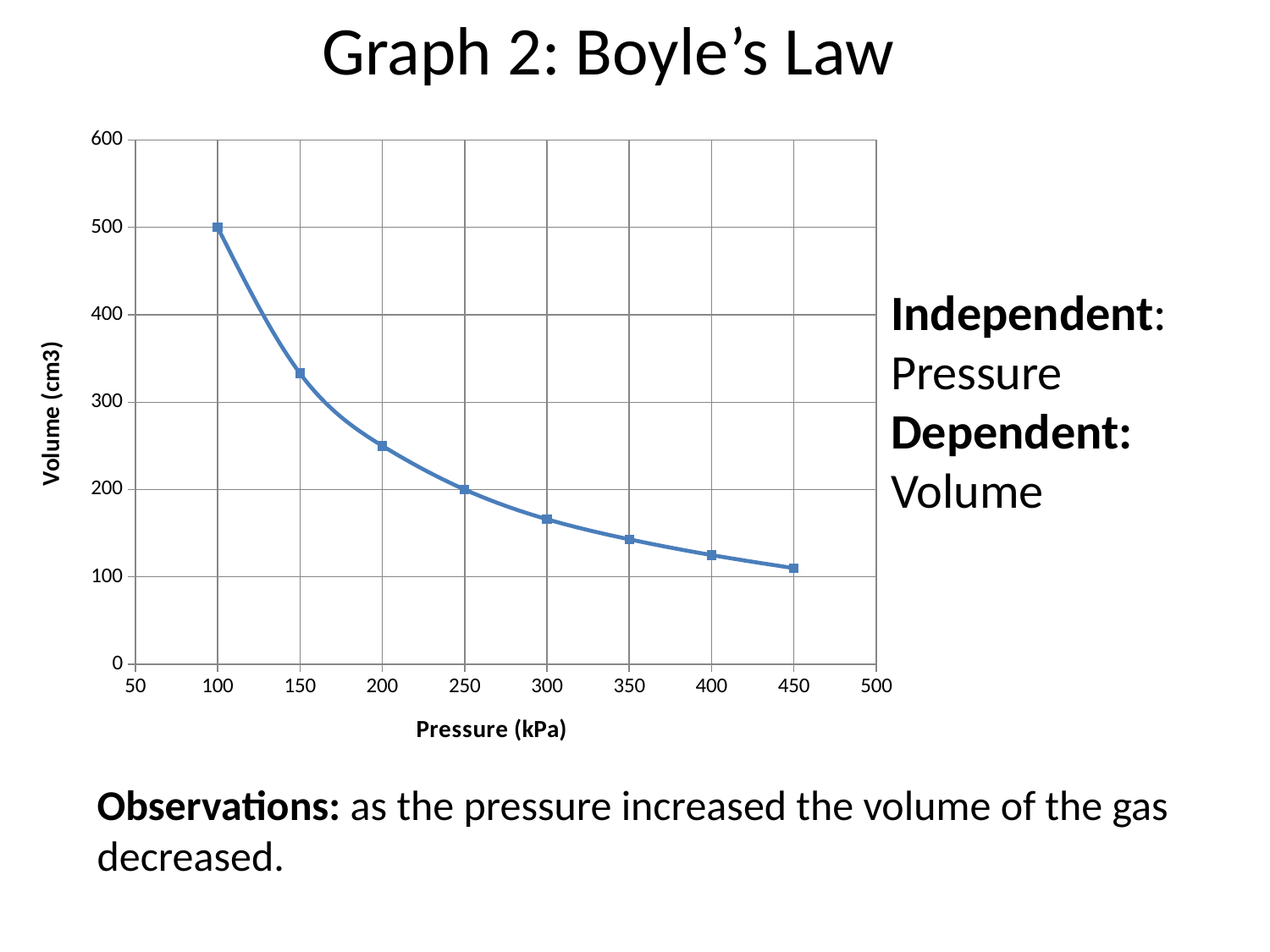
Which has the larger volume, 150 kPa or 300 kPa? 150 kPa Is the volume at 350 kPa greater or less than 200? less What is the volume at a pressure of 100 kPa? 500 What is the difference in volume between 100 kPa and 250 kPa? 300 What kind of chart is shown on the slide? line chart Is the volume at 150 kPa greater or less than 300? greater At which pressure is the volume lowest? 450 kPa How many data points are plotted on the chart? 8 What is the volume at a pressure of 250 kPa? 200 At which pressure is the volume highest? 100 kPa Does the volume rise or fall as pressure increases along the x axis? fall What is the label of the x axis? Pressure (kPa)